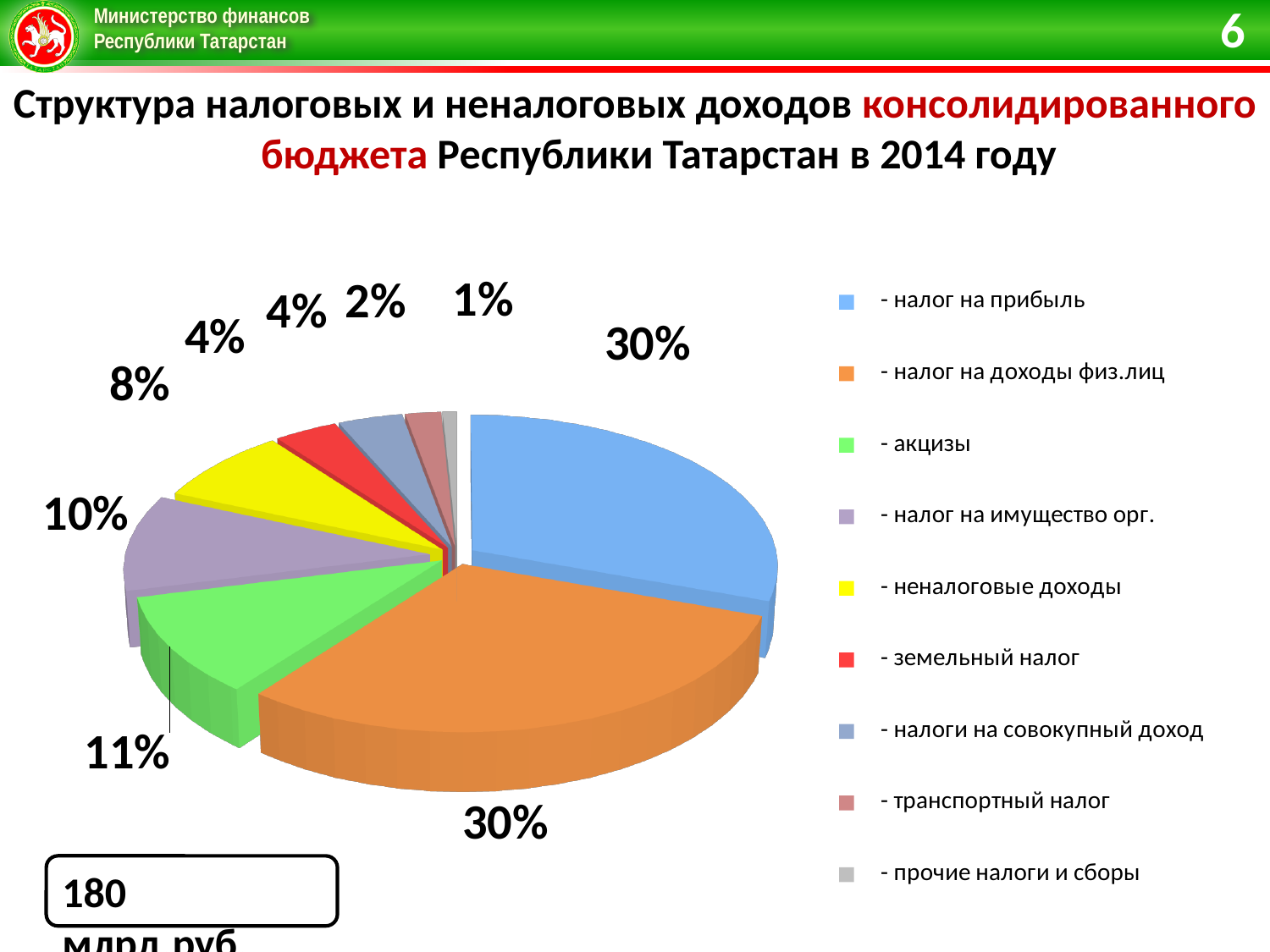
Which is larger: the share for "акцизы" or the share for "налог на имущество орг."? акцизы Which category has the smallest share of the pie? прочие налоги и сборы What colour is the slice for "неналоговые доходы"? yellow What share of the pie does "налог на имущество орг." have? 10% What kind of chart is shown on the slide? pie chart What share of the pie does "неналоговые доходы" have? 8% What share of the pie does "налог на прибыль" have? 30% What share of the pie does "транспортный налог" have? 2% What share of the pie does "налог на доходы физ.лиц" have? 30% How many categories does the legend list? 9 What share of the pie does "акцизы" have? 11% What is the difference in percentage points between the share for "налог на прибыль" and the share for "акцизы"? 19